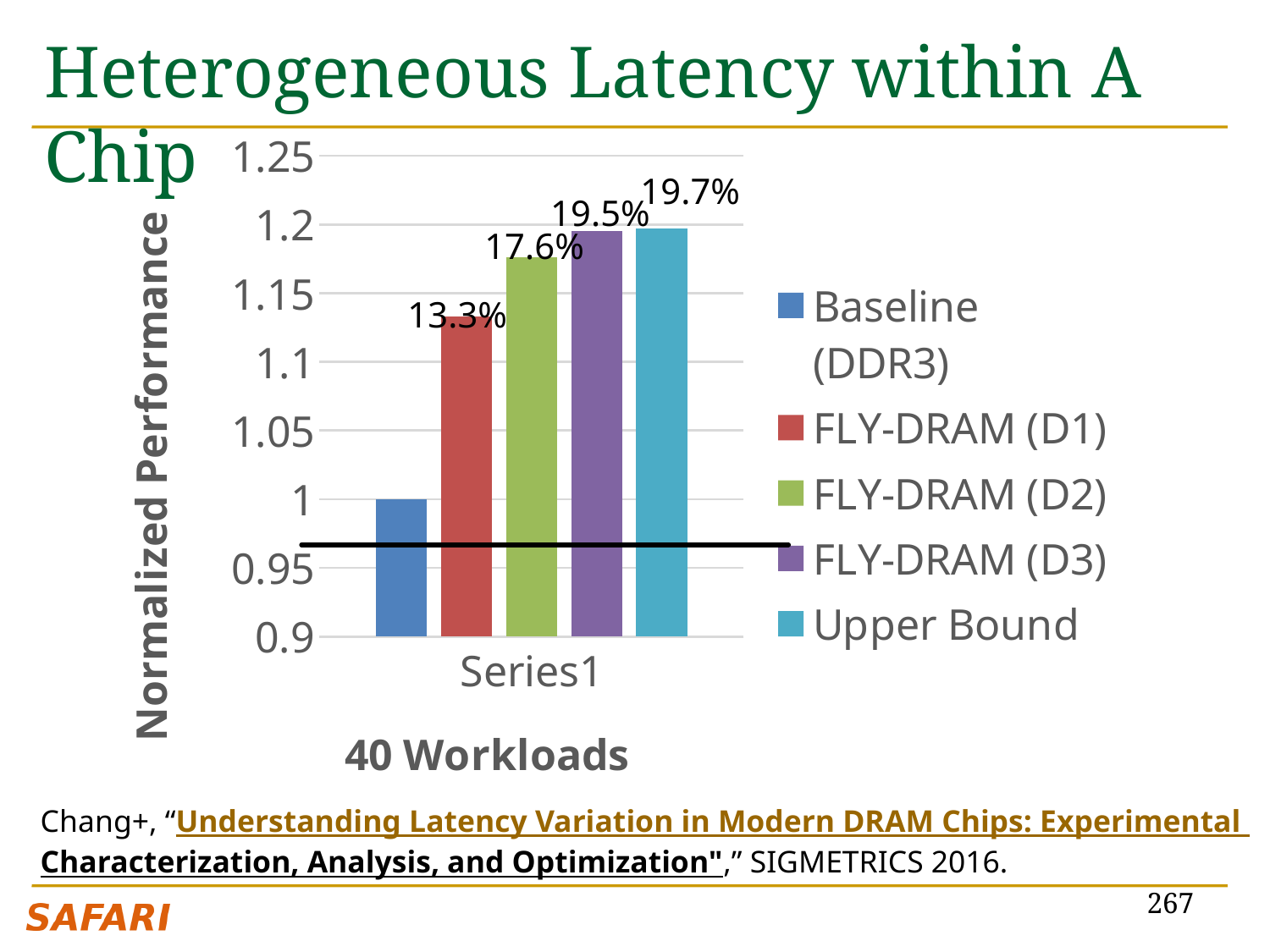
Is the normalized performance for FLY-DRAM (D2) greater or less than 1.2? less What data label is shown on the FLY-DRAM (D3) bar? 19.5% What is the normalized performance of the Baseline (DDR3) bar? 1 Is the normalized performance for FLY-DRAM (D1) greater or less than 1.1? greater How many series does the legend list? 5 What is the title of the vertical axis? Normalized Performance What data label is shown on the Upper Bound bar? 19.7% What data label is shown on the FLY-DRAM (D2) bar? 17.6% Which series has the shortest bar? Baseline (DDR3) Which series has the tallest bar? Upper Bound Which bar is taller, FLY-DRAM (D1) or FLY-DRAM (D2)? FLY-DRAM (D2) What data label is shown on the FLY-DRAM (D1) bar? 13.3%